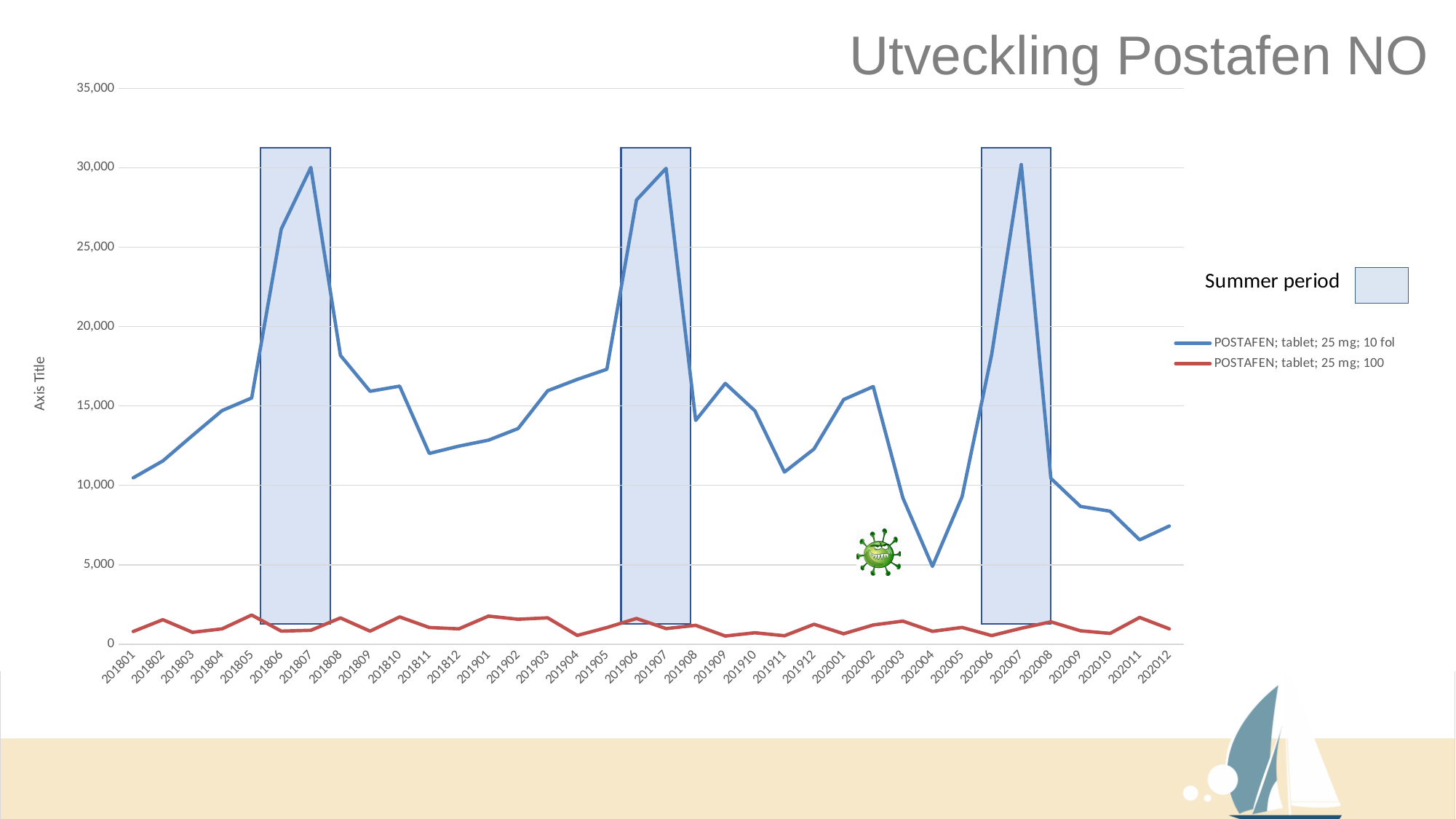
Which series has the larger value at 201801, 'POSTAFEN; tablet; 25 mg; 10 fol' or 'POSTAFEN; tablet; 25 mg; 100'? POSTAFEN; tablet; 25 mg; 10 fol Is the value of the 'POSTAFEN; tablet; 25 mg; 10 fol' series at 202003 greater or less than 10,000? less What do the shaded blue rectangles on the chart represent? Summer period What kind of chart is shown on the slide? line chart How many monthly points are plotted along the x axis? 36 Does the 'POSTAFEN; tablet; 25 mg; 10 fol' series rise or fall from 202008 to 202011? fall Is the value of the 'POSTAFEN; tablet; 25 mg; 100' series at 201901 greater or less than 5,000? less Is the value of the 'POSTAFEN; tablet; 25 mg; 10 fol' series at 201807 greater or less than 25,000? greater How many data series does the chart legend list? 2 At which month does the 'POSTAFEN; tablet; 25 mg; 10 fol' series reach its lowest value? 202004 What is the title of the chart on the slide? Utveckling Postafen NO